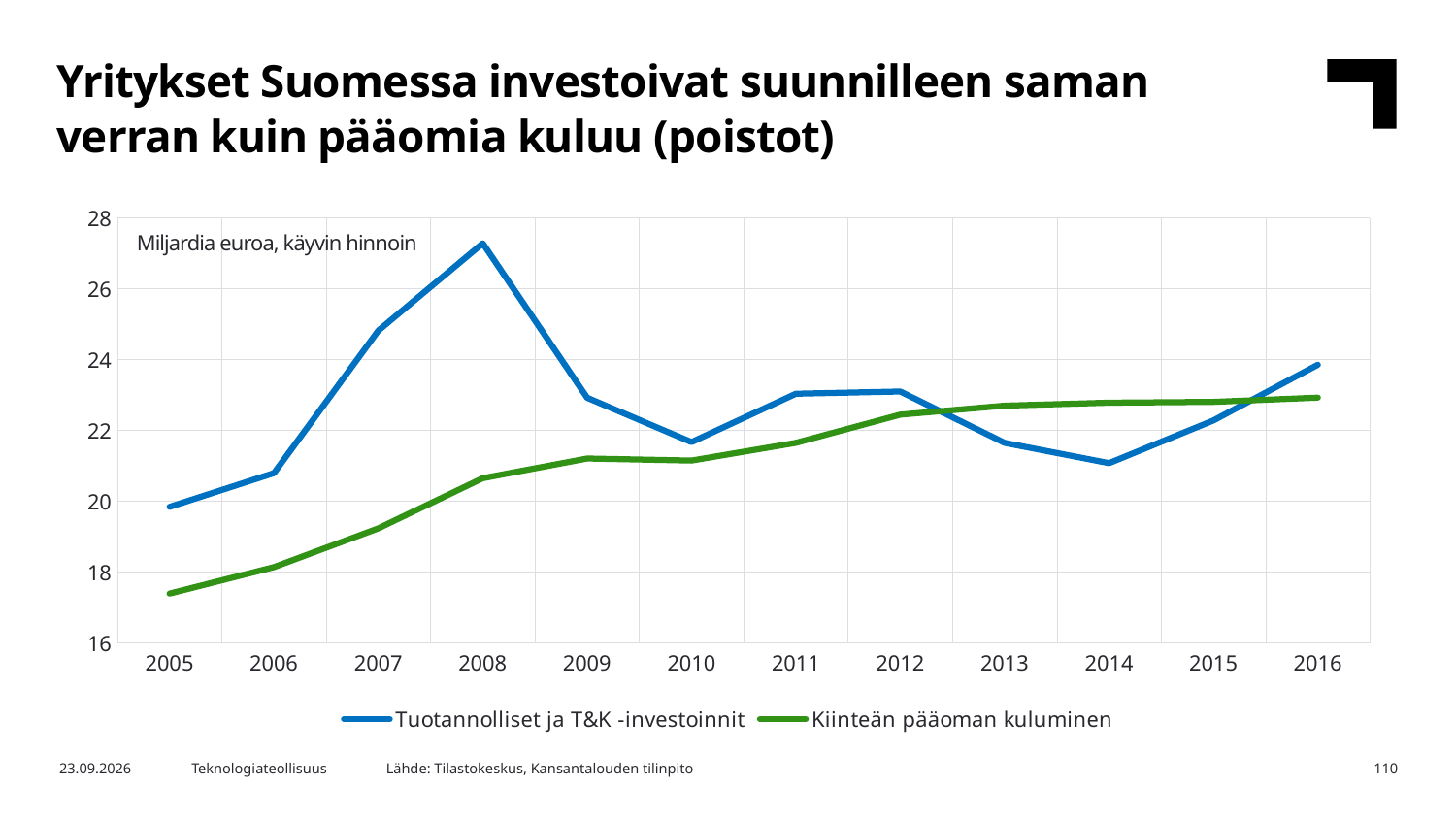
Is the value for Tuotannolliset ja T&K -investoinnit in 2014 greater or less than 22? less What kind of chart is shown on the slide? line chart In 2014, which series has the higher value: Tuotannolliset ja T&K -investoinnit or Kiinteän pääoman kuluminen? Kiinteän pääoman kuluminen Is the value for Kiinteän pääoman kuluminen in 2005 greater or less than 18? less How many years are shown on the x axis? 12 Does the Kiinteän pääoman kuluminen line generally rise or fall from 2005 to 2016? rise In 2007, which series has the higher value: Tuotannolliset ja T&K -investoinnit or Kiinteän pääoman kuluminen? Tuotannolliset ja T&K -investoinnit In which year does the Tuotannolliset ja T&K -investoinnit line reach its highest value? 2008 In which year is the Kiinteän pääoman kuluminen line at its lowest value? 2005 How many series does the legend list? 2 In which year is the Tuotannolliset ja T&K -investoinnit line at its lowest value? 2005 Is the value for Tuotannolliset ja T&K -investoinnit in 2008 greater or less than 26? greater